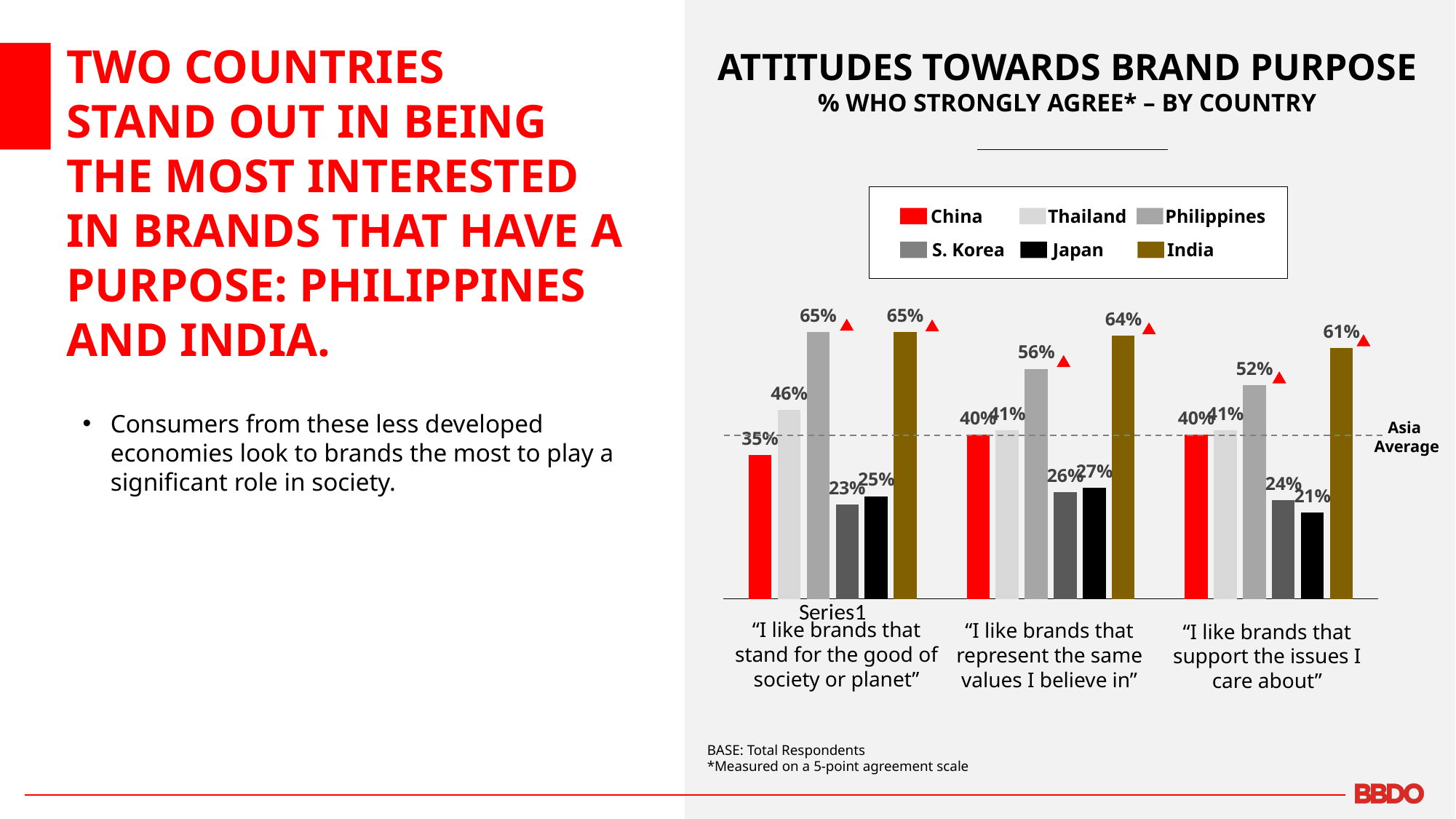
What is the difference between India and China for "I like brands that support the issues I care about"? 21 percentage points What is the difference between Philippines and S. Korea for "I like brands that represent the same values I believe in"? 30 percentage points For "I like brands that represent the same values I believe in", which is larger: Philippines or India? India How many statement categories are shown on the x axis? 3 What is the value for Japan for "I like brands that support the issues I care about"? 21% What type of chart is shown on the slide? Bar chart What is the value for China for "I like brands that stand for the good of society or planet"? 35% Which country has the highest value for "I like brands that support the issues I care about"? India What is the value for Thailand for "I like brands that stand for the good of society or planet"? 46% How many series does the legend list? 6 What percentage of respondents in India strongly agree with "I like brands that represent the same values I believe in"? 64% Which country has the lowest value for "I like brands that stand for the good of society or planet"? S. Korea